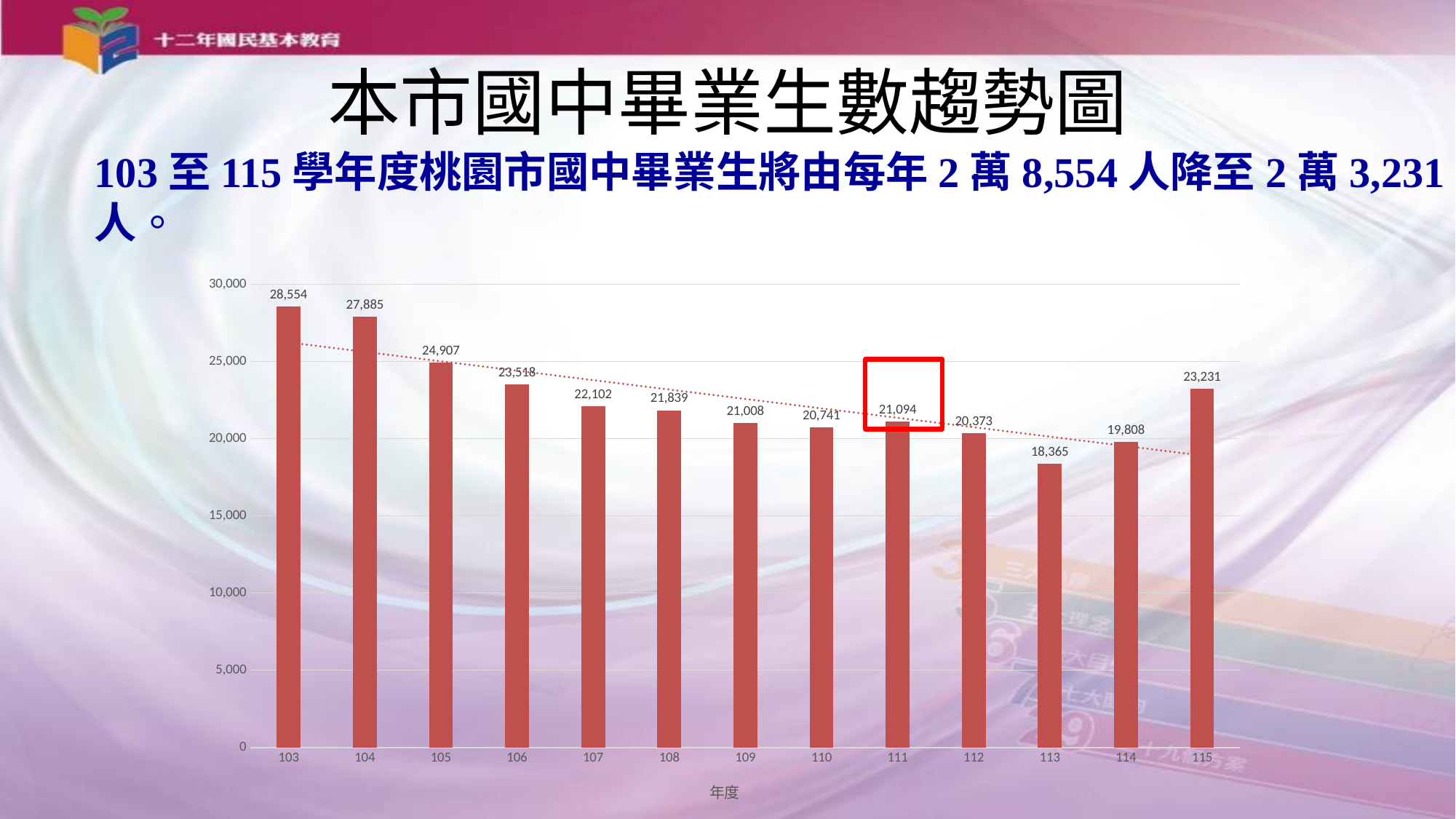
What is the difference between the values for year 114 and year 113? 1,443 What is the value for year 115? 23,231 What is the value for year 103? 28,554 How many years are shown on the x axis? 13 What is the difference between the values for year 103 and year 115? 5,323 Which is larger, the value for year 105 or the value for year 106? 105 Is the value for year 113 greater or less than 20,000? less What is the label of the x axis? 年度 Which year has the lowest value? 113 Which year has the highest value? 103 What kind of chart is shown on the slide? bar chart What is the value for year 111? 21,094